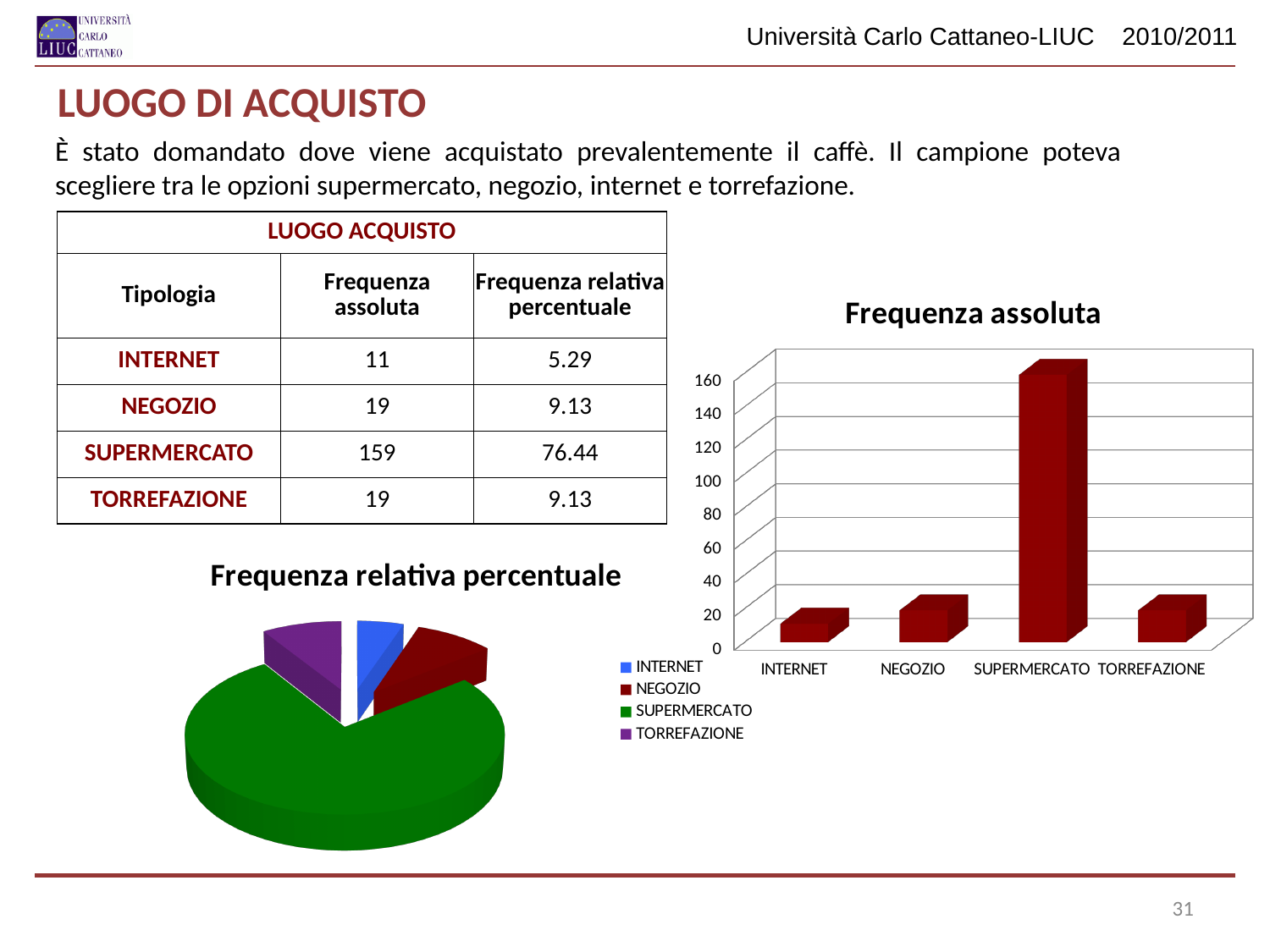
In the 'Frequenza relativa percentuale' pie chart, which category has the largest slice? SUPERMERCATO In the 'Frequenza assoluta' chart, is the value for SUPERMERCATO greater or less than 140? greater In the 'Frequenza assoluta' chart, is the value for TORREFAZIONE greater or less than 40? less What kind of chart is the 'Frequenza assoluta' chart? bar chart In the 'Frequenza assoluta' chart, which is larger, the value for INTERNET or the value for SUPERMERCATO? SUPERMERCATO How many entries does the legend of the 'Frequenza relativa percentuale' chart list? 4 In the 'Frequenza assoluta' chart, which category has the highest value? SUPERMERCATO How many categories are shown in the 'Frequenza assoluta' chart? 4 In the 'Frequenza assoluta' chart, which category has the lowest value? INTERNET What kind of chart is the 'Frequenza relativa percentuale' chart? pie chart In the 'Frequenza relativa percentuale' pie chart, what colour is the SUPERMERCATO slice according to the legend? green In the 'Frequenza assoluta' chart, is the value for INTERNET greater or less than 20? less